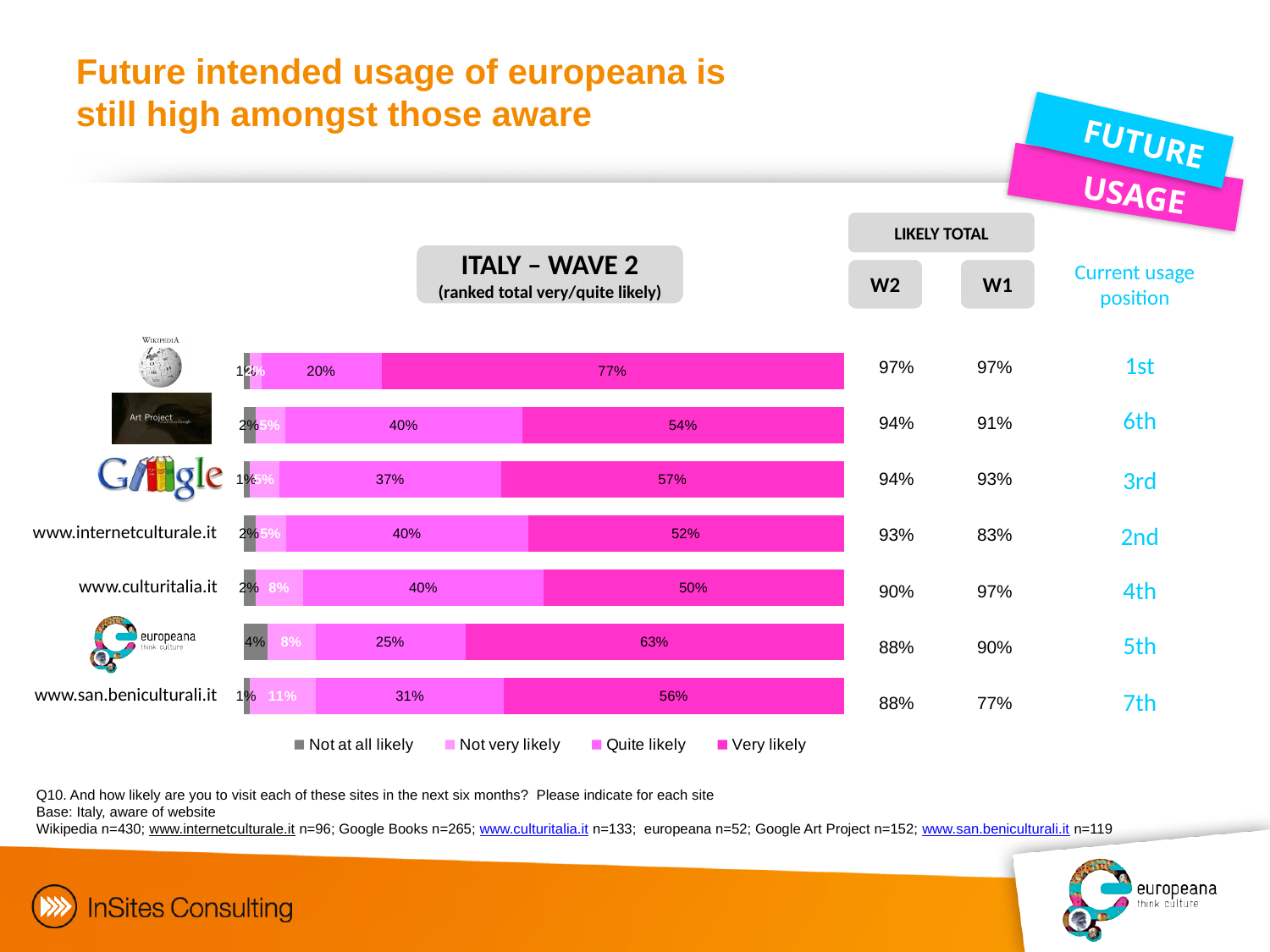
What is the 'Very likely' value for europeana? 63% What percentage of respondents are 'Very likely' to visit Wikipedia in the next six months? 77% Which site has the highest 'Very likely' percentage? Wikipedia How many series does the legend list? 4 What is the 'Not very likely' value for www.san.beniculturali.it? 11% Which has a larger 'Quite likely' value, Google or www.san.beniculturali.it? Google How many sites are shown in the chart? 7 What is the 'Quite likely' value for www.internetculturale.it? 40% What is the title of the chart? ITALY – WAVE 2 What type of chart is shown on the slide? Stacked bar chart What is the difference between the 'Very likely' values for Google and Art Project? 3 percentage points Which site has the lowest 'Very likely' percentage? www.culturitalia.it